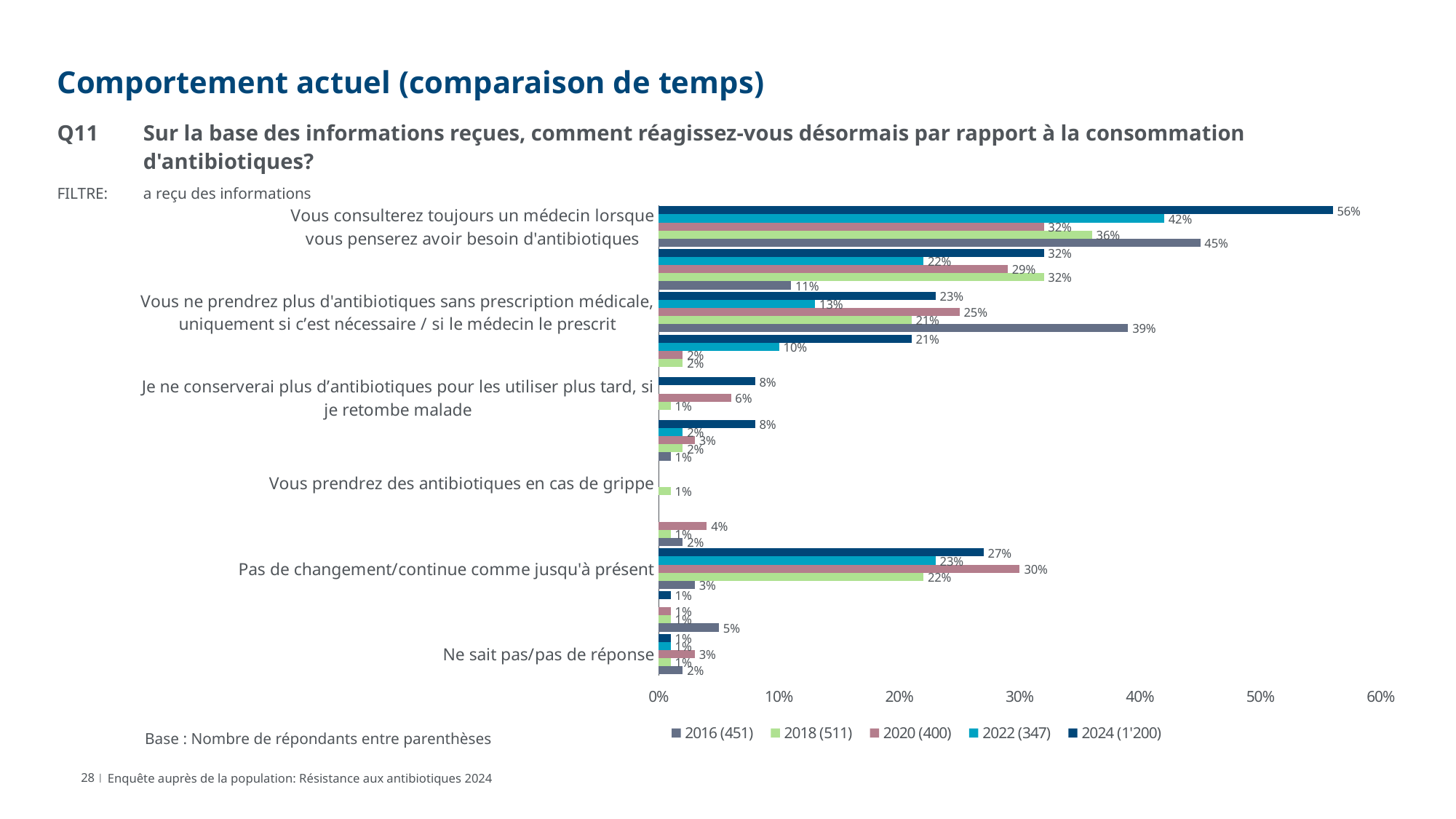
What kind of chart is shown on the slide? bar chart What is the 2016 value for "Vous consulterez toujours un médecin lorsque vous penserez avoir besoin d'antibiotiques"? 45% Which survey year has the highest value for "Vous consulterez toujours un médecin lorsque vous penserez avoir besoin d'antibiotiques"? 2024 (1'200) What is the 2024 value for "Vous consulterez toujours un médecin lorsque vous penserez avoir besoin d'antibiotiques"? 56% For "Pas de changement/continue comme jusqu'à présent", which is larger: the 2024 value or the 2016 value? 2024 What is the 2020 value for "Pas de changement/continue comme jusqu'à présent"? 30% Which survey year has the lowest value for "Vous ne prendrez plus d'antibiotiques sans prescription médicale, uniquement si c'est nécessaire / si le médecin le prescrit"? 2022 (347) What is the difference between the 2024 and 2022 values for "Vous consulterez toujours un médecin lorsque vous penserez avoir besoin d'antibiotiques"? 14 percentage points According to the legend, how many respondents does the 2024 series have? 1'200 What is the 2016 value for "Vous ne prendrez plus d'antibiotiques sans prescription médicale, uniquement si c'est nécessaire / si le médecin le prescrit"? 39% How many series does the legend list? 5 Is the 2024 value for "Pas de changement/continue comme jusqu'à présent" greater or less than 20%? greater